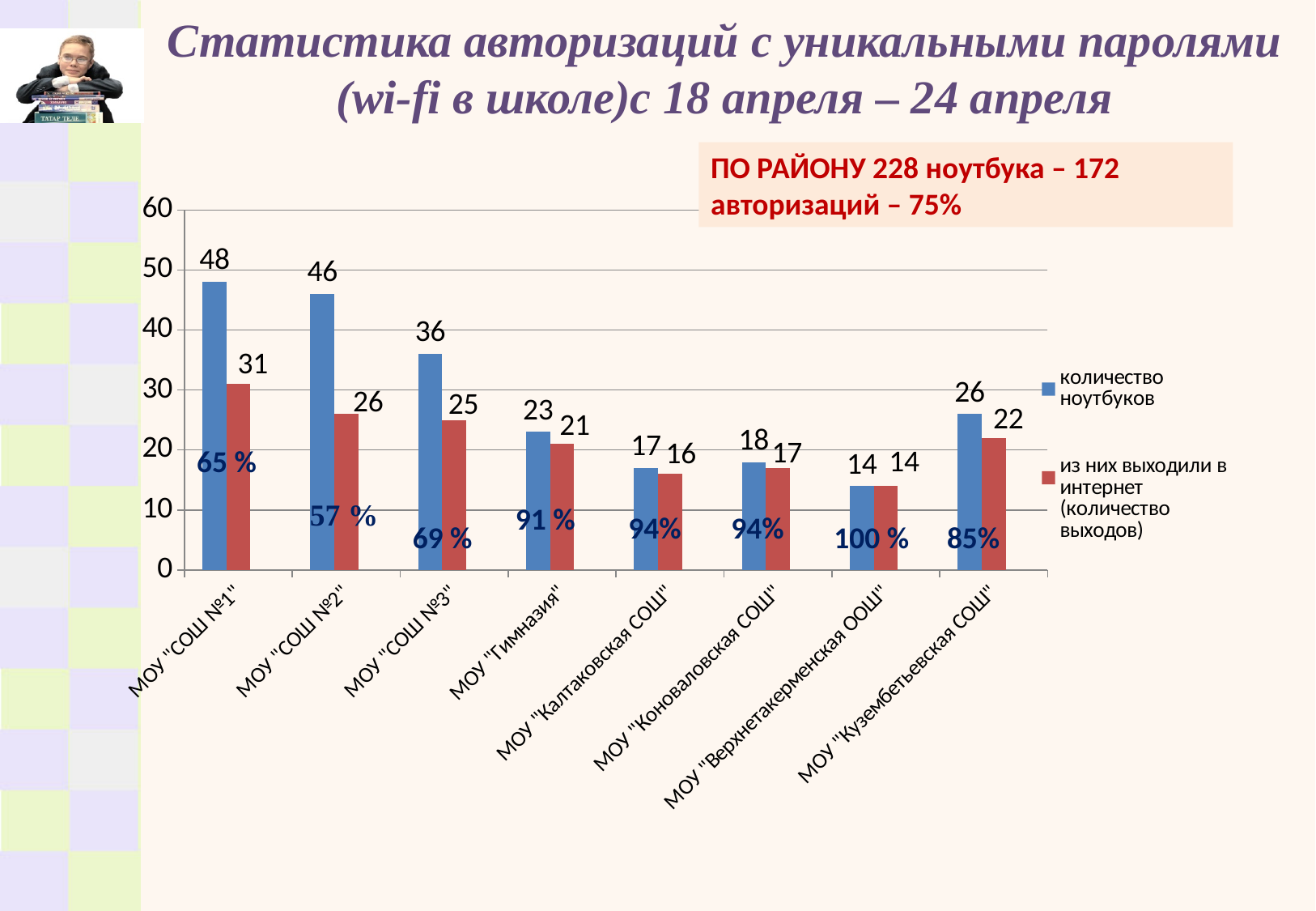
What kind of chart is shown on the slide? bar chart How many categories are shown on the x axis? 8 What is the difference between "количество ноутбуков" and "из них выходили в интернет (количество выходов)" for МОУ "СОШ №2"? 20 What is the value of "количество ноутбуков" for МОУ "Кузембетьевская СОШ"? 26 Which category has the lowest value of "количество ноутбуков"? МОУ "Верхнетакерменская ООШ" What is the value of "количество ноутбуков" for МОУ "СОШ №1"? 48 Which is larger: "количество ноутбуков" for МОУ "СОШ №3" or for МОУ "Кузембетьевская СОШ"? МОУ "СОШ №3" What percentage is printed above the bars for МОУ "Верхнетакерменская ООШ"? 100 % Is the value of "из них выходили в интернет (количество выходов)" for МОУ "СОШ №1" greater or less than 30? greater Which category has the highest value of "количество ноутбуков"? МОУ "СОШ №1" What is the value of "из них выходили в интернет (количество выходов)" for МОУ "Гимназия"? 21 How many series does the legend list? 2